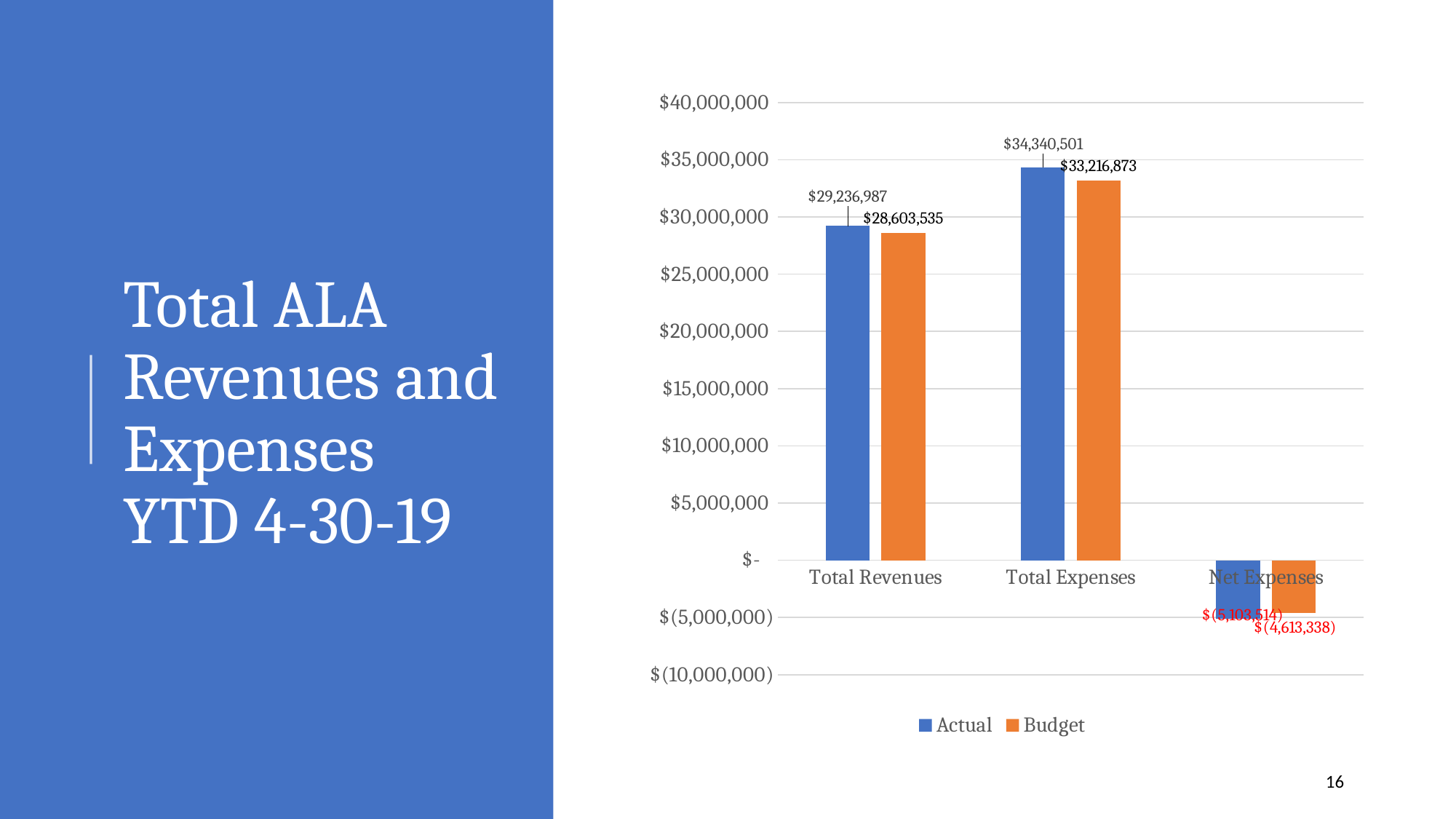
What is the Actual value for Total Revenues? $29,236,987 Which category has the lowest Budget value? Net Expenses What is the difference between the Actual and Budget values for Total Revenues? $633,452 What kind of chart is shown on the slide? Bar chart Which is larger for Total Expenses, the Actual value or the Budget value? Actual What is the Actual value for Net Expenses? $(5,103,514) What is the Budget value for Total Revenues? $28,603,535 What is the Budget value for Total Expenses? $33,216,873 How many categories are shown on the x axis? 3 Which category has the highest Actual value? Total Expenses How many series does the legend list? 2 What is the difference between the Actual and Budget values for Total Expenses? $1,123,628